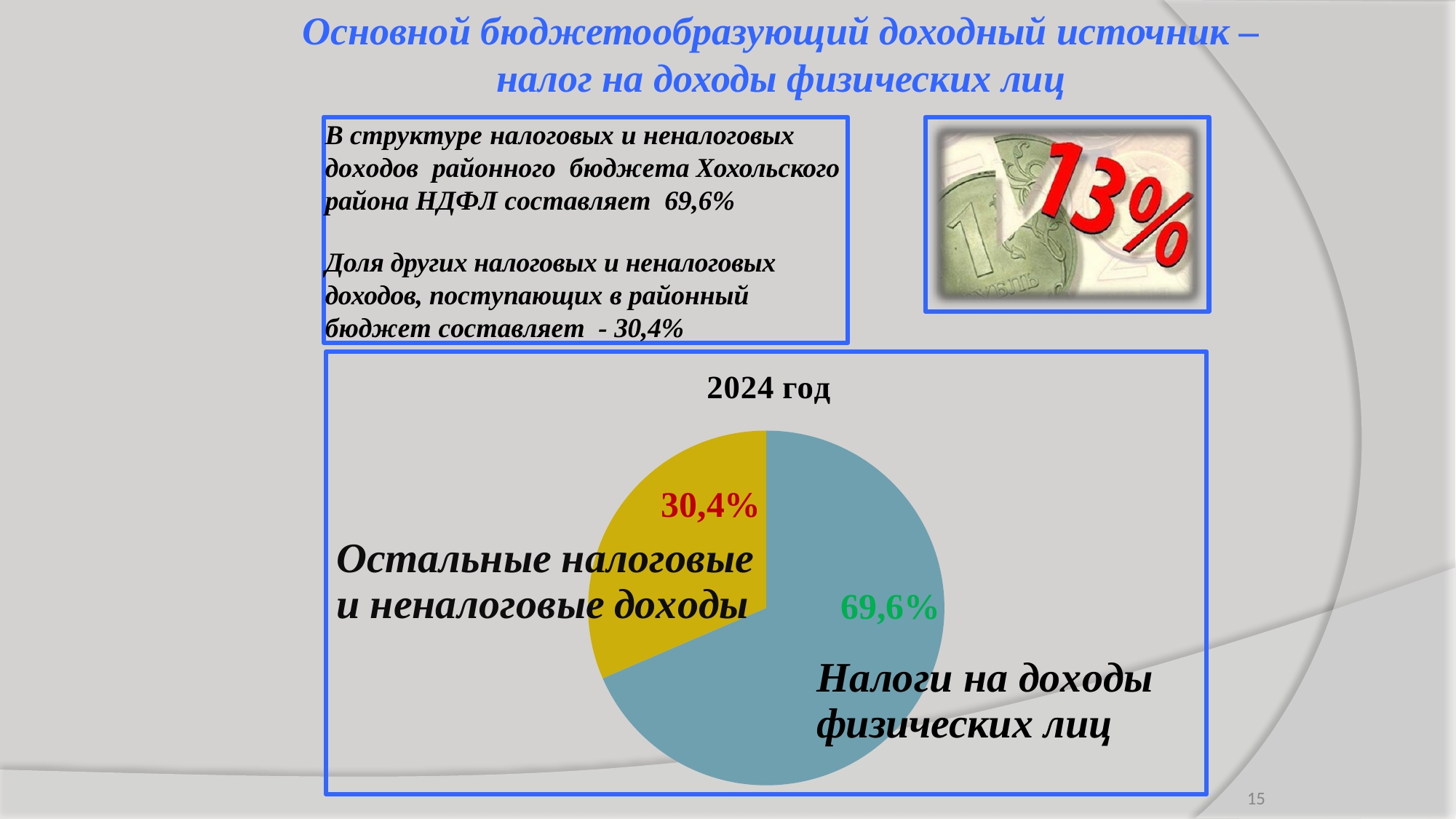
Which slice of the pie is the smallest? Остальные налоговые и неналоговые доходы What share of the pie is labelled "Остальные налоговые и неналоговые доходы"? 30,4% What is the difference in percentage points between the "Налоги на доходы физических лиц" slice and the "Остальные налоговые и неналоговые доходы" slice? 39,2 What colour is the slice for "Остальные налоговые и неналоговые доходы"? yellow What share of the pie is labelled "Налоги на доходы физических лиц"? 69,6% Which slice of the pie is the largest? Налоги на доходы физических лиц What is the chart's title? 2024 год Which is larger: the share for "Налоги на доходы физических лиц" or the share for "Остальные налоговые и неналоговые доходы"? Налоги на доходы физических лиц What kind of chart is shown on the slide? pie chart How many slices does the pie chart have? 2 Is the share for "Налоги на доходы физических лиц" greater or less than 50%? greater